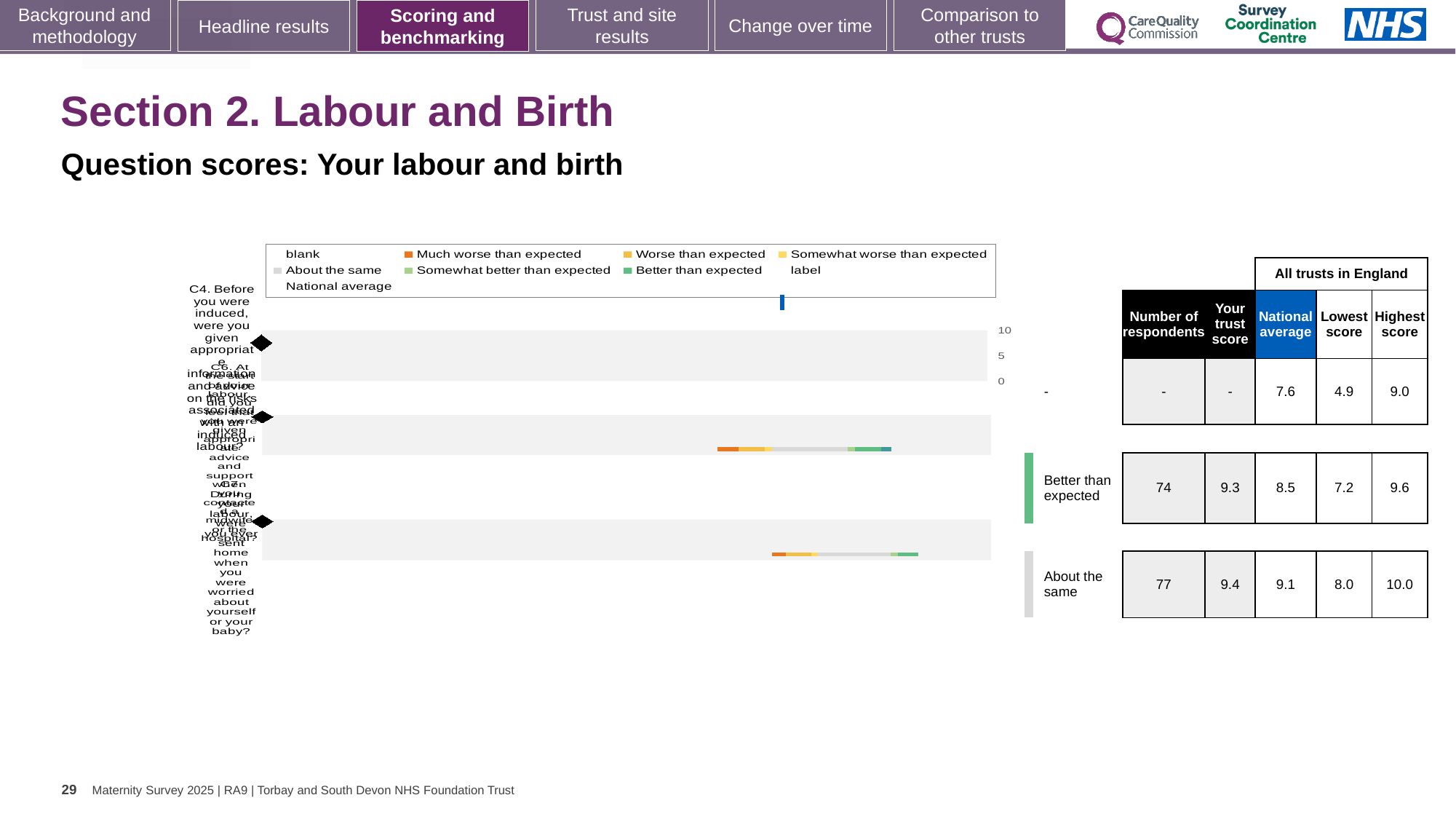
In the table, what is the highest score for the row rated 'About the same'? 10.0 In the table, which row has more respondents: 'Better than expected' or 'About the same'? About the same What is the subtitle describing the chart on this slide? Question scores: Your labour and birth In the table, how many respondents are listed for the row rated 'Better than expected'? 74 In the table, what is the difference between the trust score and the national average for the row rated 'Better than expected'? 0.8 In the table, what is the lowest score for the first row (the one with no trust score)? 4.9 In the table, what is the difference between the highest score and the lowest score for the first row (the one with no trust score)? 4.1 In the table, what is the national average for the first row (the one with no trust score)? 7.6 What kind of chart is shown on the slide? bar chart In the table, what is the national average for the row rated 'Better than expected'? 8.5 In the table, for the row rated 'About the same', which is larger: the trust score or the national average? the trust score In the table, what is the trust score for the row rated 'About the same'? 9.4